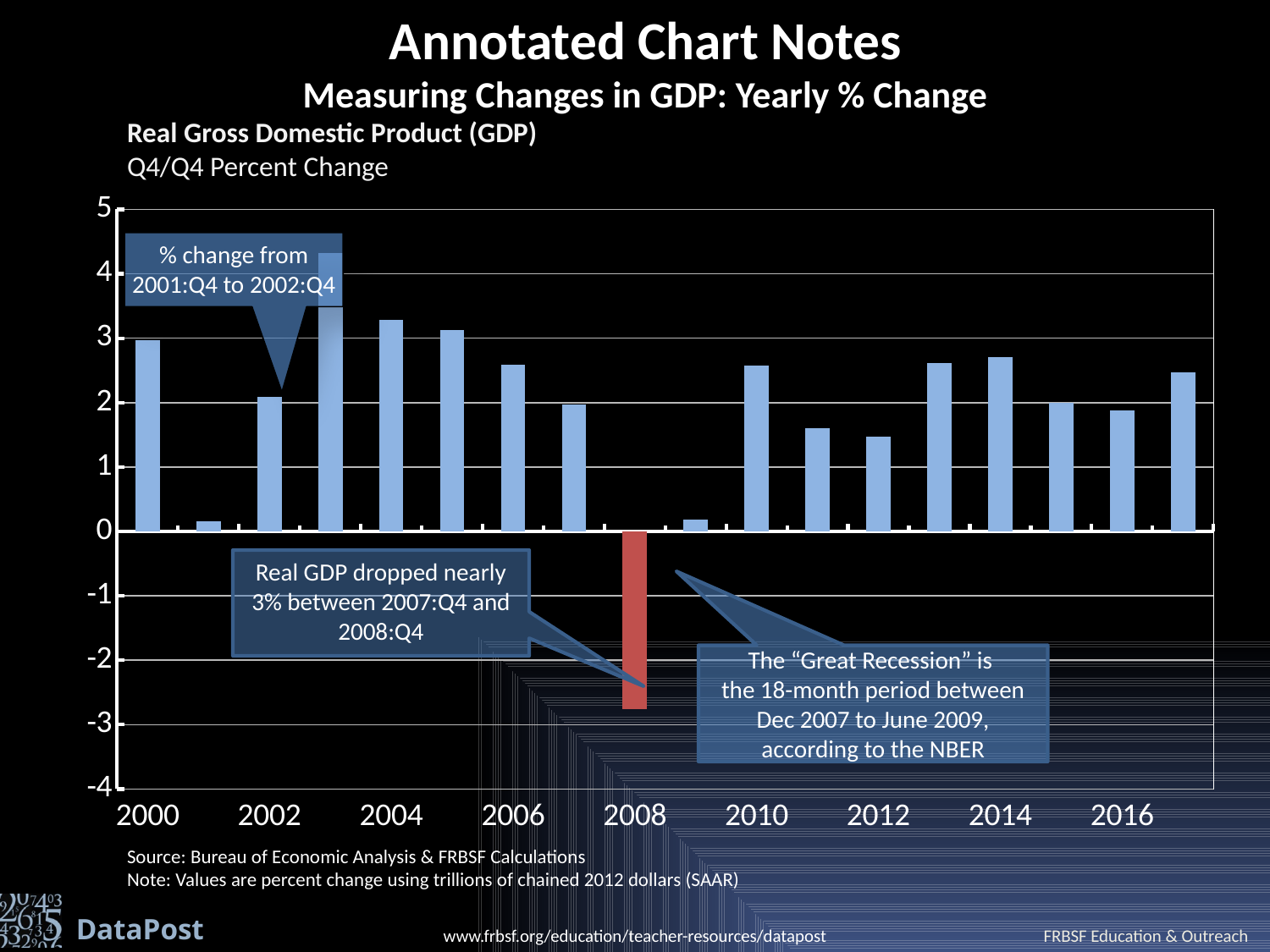
Is the value for 2004 greater or less than 3? greater Is the value for 2003 greater or less than 4? greater Is the value for 2001 greater or less than 1? less Which year has the larger value, 2000 or 2002? 2000 How many yearly bars are plotted in the chart? 18 What kind of chart is shown on the slide? Bar chart Which year has the lowest Q4/Q4 percent change in real GDP? 2008 Which year has the highest Q4/Q4 percent change in real GDP? 2003 What is the subtitle of the chart describing the measure plotted? Q4/Q4 Percent Change Which year has the larger value, 2011 or 2014? 2014 Which year's bar is coloured red instead of blue? 2008